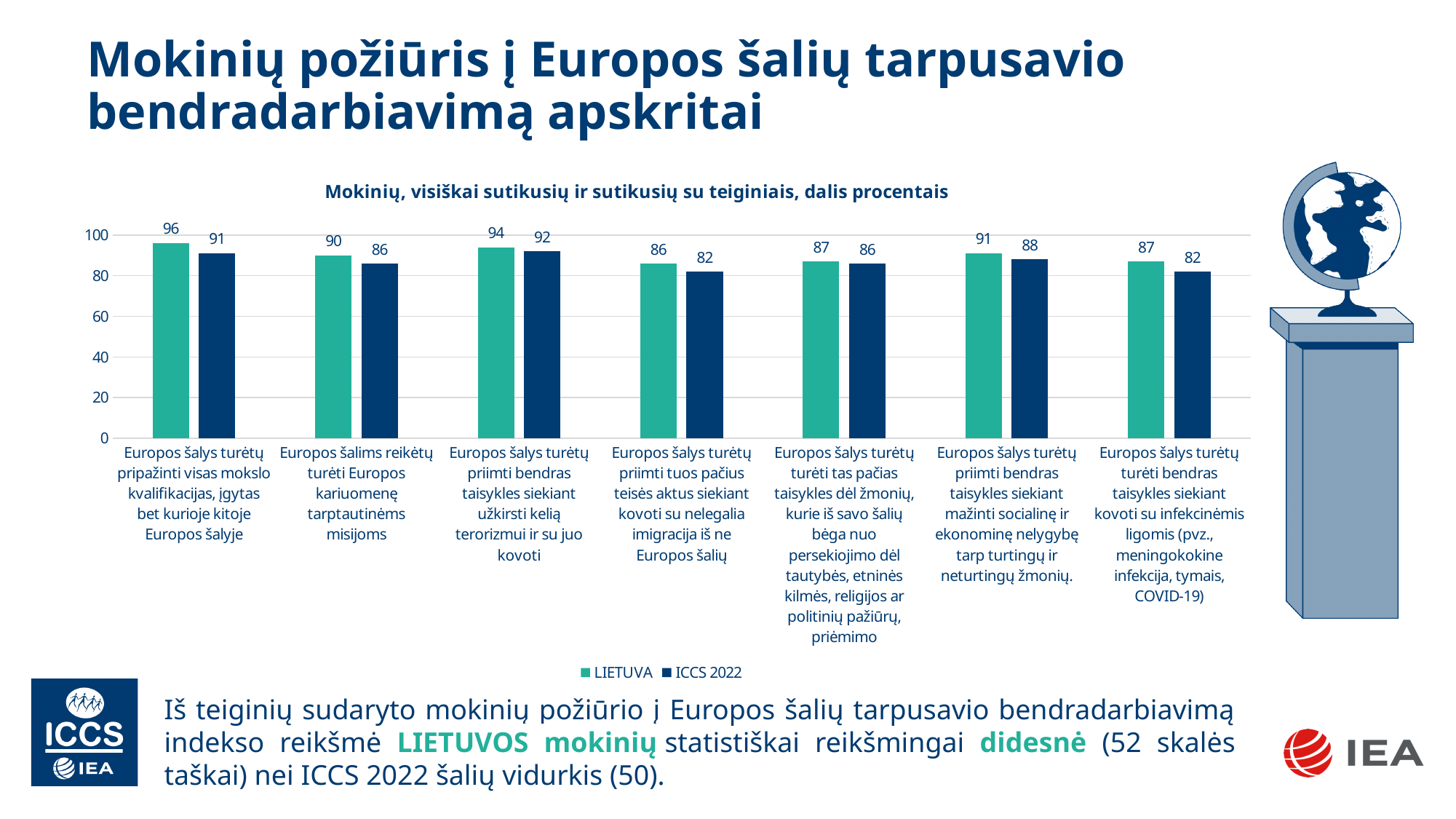
Which statement has the lowest LIETUVA value? Europos šalys turėtų priimti tuos pačius teisės aktus siekiant kovoti su nelegalia imigracija iš ne Europos šalių What is the difference between the LIETUVA and ICCS 2022 values for the statement about fighting terrorism ("užkirsti kelią terorizmui")? 2 For the statement about reducing social and economic inequality ("mažinti socialinę ir ekonominę nelygybę"), which is larger: the LIETUVA value or the ICCS 2022 value? LIETUVA How many statements (categories) are shown on the x axis of the chart? 7 What kind of chart is shown on the slide? Bar chart What is the LIETUVA value for the statement "Europos šalys turėtų pripažinti visas mokslo kvalifikacijas, įgytas bet kurioje kitoje Europos šalyje"? 96 How many series does the chart legend list? 2 Which statement has the highest LIETUVA value? Europos šalys turėtų pripažinti visas mokslo kvalifikacijas, įgytas bet kurioje kitoje Europos šalyje What is the ICCS 2022 value for the statement about common rules to fight infectious diseases ("kovoti su infekcinėmis ligomis")? 82 What is the difference between the LIETUVA and ICCS 2022 values for the statement about recognising academic qualifications ("pripažinti visas mokslo kvalifikacijas")? 5 What is the ICCS 2022 value for the statement "Europos šalims reikėtų turėti Europos kariuomenę tarptautinėms misijoms"? 86 What is the title of the chart? Mokinių, visiškai sutikusių ir sutikusių su teiginiais, dalis procentais